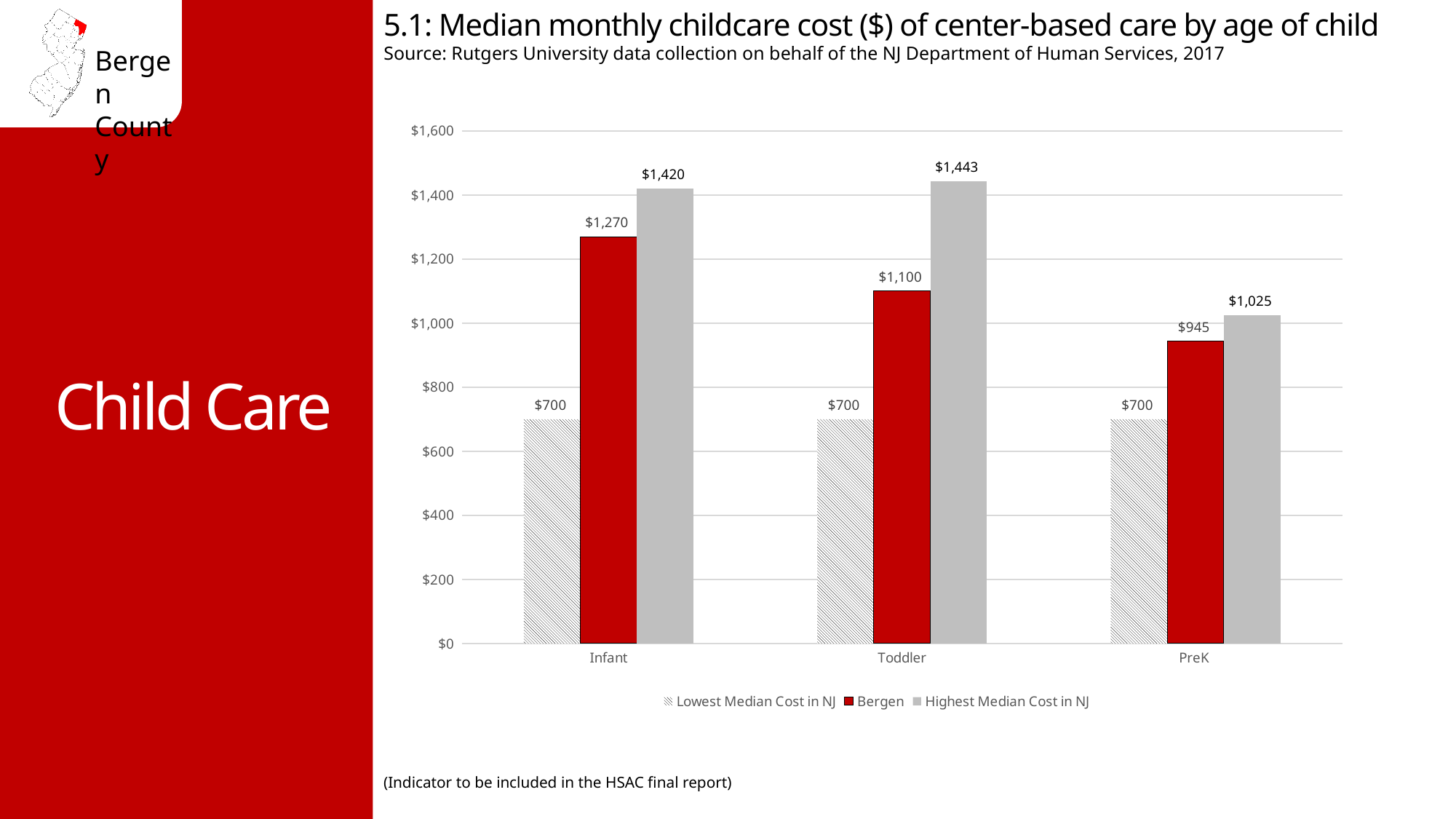
For which age group is the Highest Median Cost in NJ lowest? PreK How many series does the legend list? 3 Do the Bergen values rise or fall from Infant to PreK? Fall Which is larger: the Bergen cost for Toddler care or the Highest Median Cost in NJ for PreK care? Bergen cost for Toddler care What is the difference between the Highest Median Cost in NJ and the Bergen cost for Infant care? $150 What is the difference between the Bergen cost for Toddler care and the Bergen cost for PreK care? $155 What is the Highest Median Cost in NJ for Toddler care? $1,443 What is the Lowest Median Cost in NJ for PreK care? $700 What is the median monthly childcare cost for Bergen for Infant care? $1,270 For which age group is the Bergen median monthly cost highest? Infant What kind of chart is shown on the slide? Bar chart How many age groups are shown on the x axis? 3